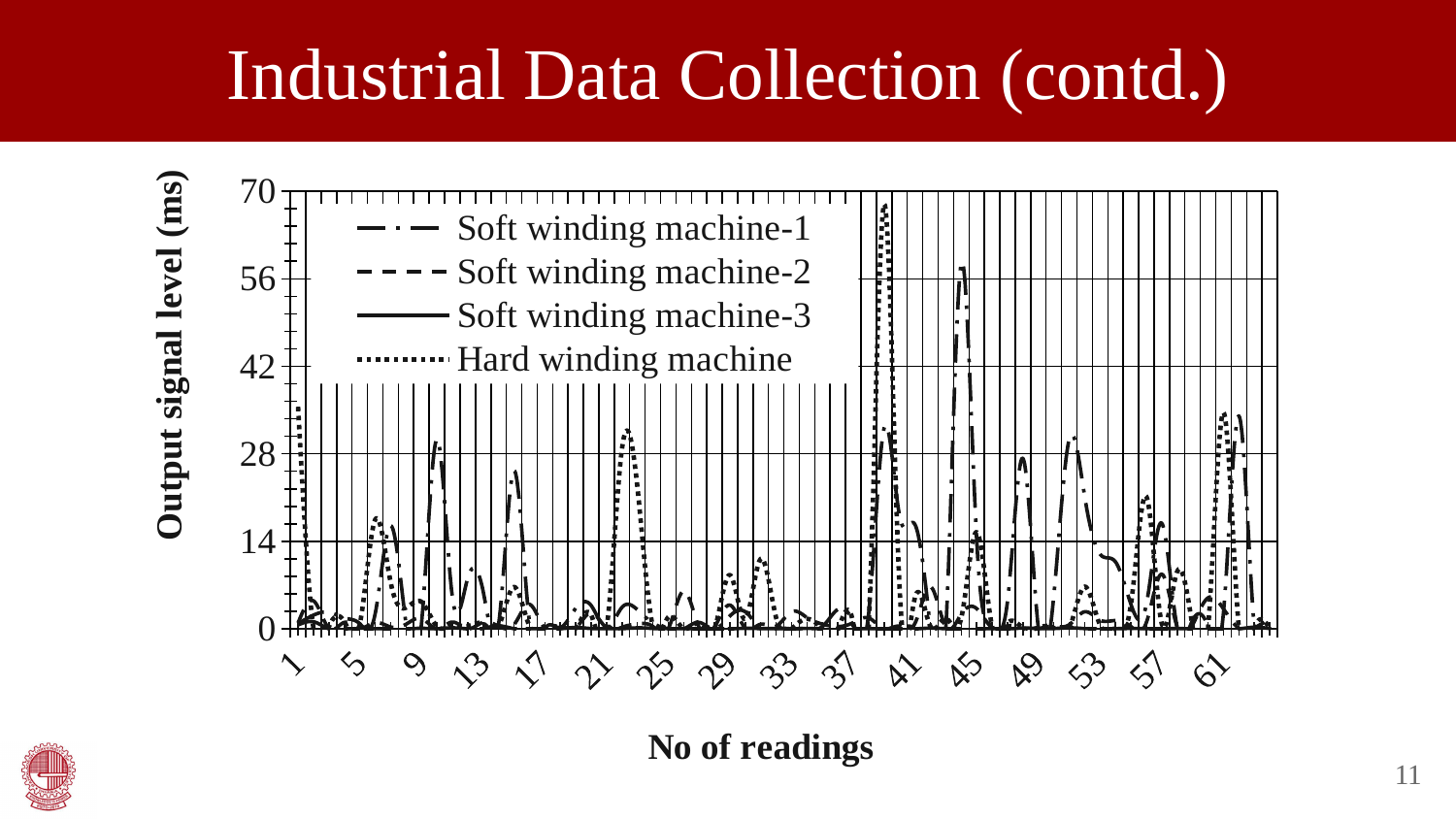
Is the peak value of the Soft winding machine-1 series near reading 44 greater or less than 42? greater What is the title of the y axis? Output signal level (ms) How many tick labels are printed along the x axis? 16 What kind of chart is shown on the slide? line chart How many series does the legend list? 4 Is the peak value of the Hard winding machine series near reading 39 greater or less than 70? less Is the value of the Hard winding machine series at reading 1 greater or less than 28? greater Which series reaches the highest output signal level anywhere on the chart? Hard winding machine What is the highest value shown on the y axis? 70 Which series is drawn with a dotted line according to the legend? Hard winding machine